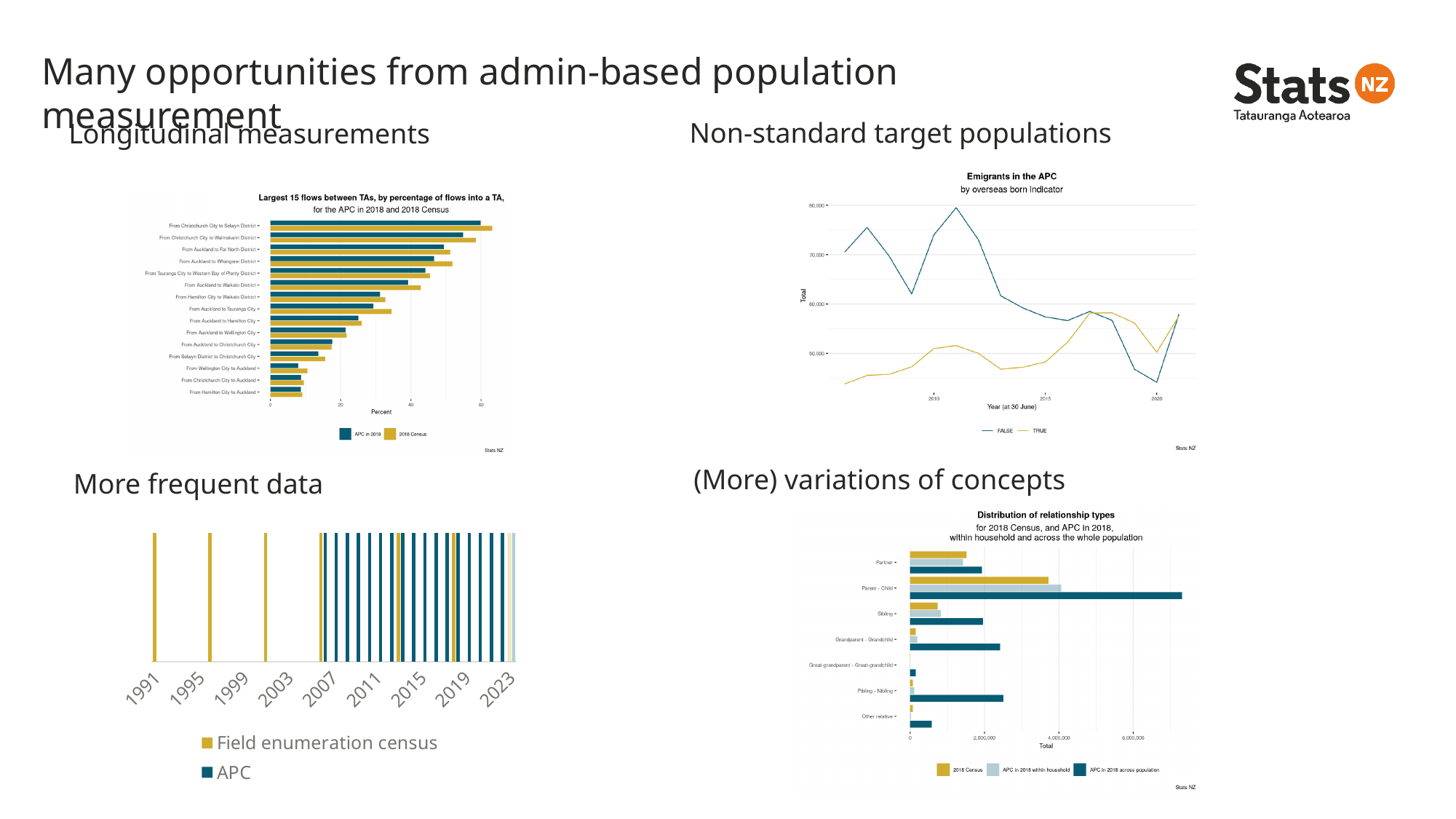
What kind of chart is the top-right chart titled 'Emigrants in the APC'? line chart In the top-left chart 'Largest 15 flows between TAs', is the 2018 Census value for 'From Christchurch City to Selwyn District' greater or less than 40? greater In the top-left chart 'Largest 15 flows between TAs', which flow has the highest APC in 2018 value? From Christchurch City to Selwyn District In the bottom-left 'More frequent data' chart, how many series does the legend list? 2 In the bottom-right chart 'Distribution of relationship types', is the 'APC in 2018 across population' value for Parent - Child greater or less than 6,000,000? greater In the top-right chart 'Emigrants in the APC', is the highest value of the FALSE line greater or less than 70,000? greater In the top-left chart 'Largest 15 flows between TAs', how many series does the legend list? 2 What kind of chart is the top-left chart titled 'Largest 15 flows between TAs'? bar chart In the bottom-right chart 'Distribution of relationship types', which relationship type has the highest 'APC in 2018 across population' value? Parent - Child In the top-left chart 'Largest 15 flows between TAs', how many flows (categories) are plotted? 15 In the top-right chart 'Emigrants in the APC', what are the two series listed in the legend? FALSE and TRUE In the bottom-right chart 'Distribution of relationship types', how many series does the legend list? 3